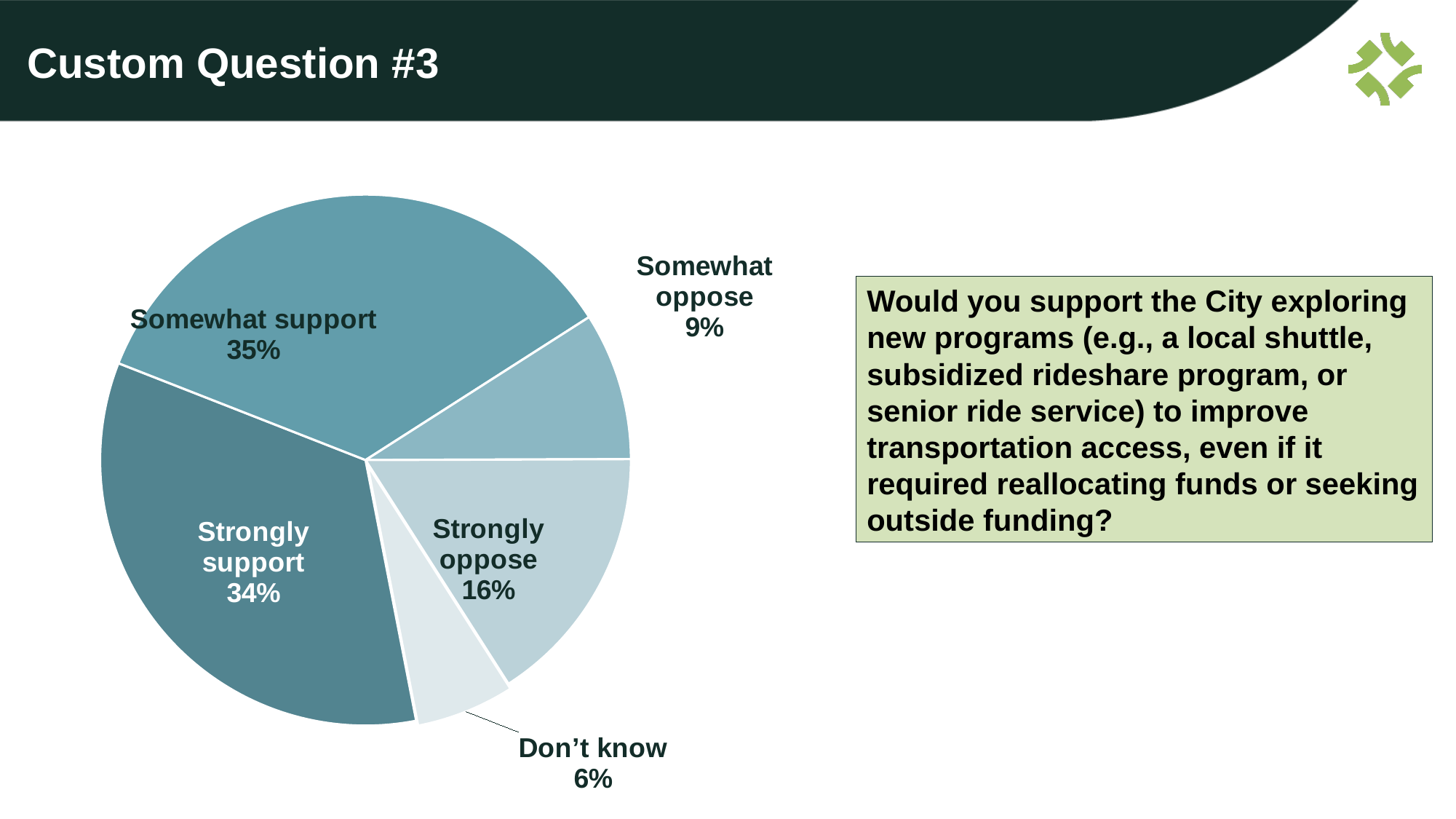
What percentage of respondents said "Strongly oppose"? 16% Which response category has the smallest share of the pie? Don't know What percentage of respondents said "Don't know"? 6% What kind of chart is shown on the slide? pie chart What is the difference in percentage points between "Strongly oppose" and "Somewhat oppose"? 7 Which is larger, the share for "Strongly oppose" or the share for "Don't know"? Strongly oppose What percentage of respondents said "Strongly support"? 34% How many response categories are shown in the pie chart? 5 Which response category has the largest share of the pie? Somewhat support What percentage of respondents said "Somewhat oppose"? 9% What is the combined percentage of "Somewhat support" and "Strongly support"? 69% What percentage of respondents said "Somewhat support"? 35%